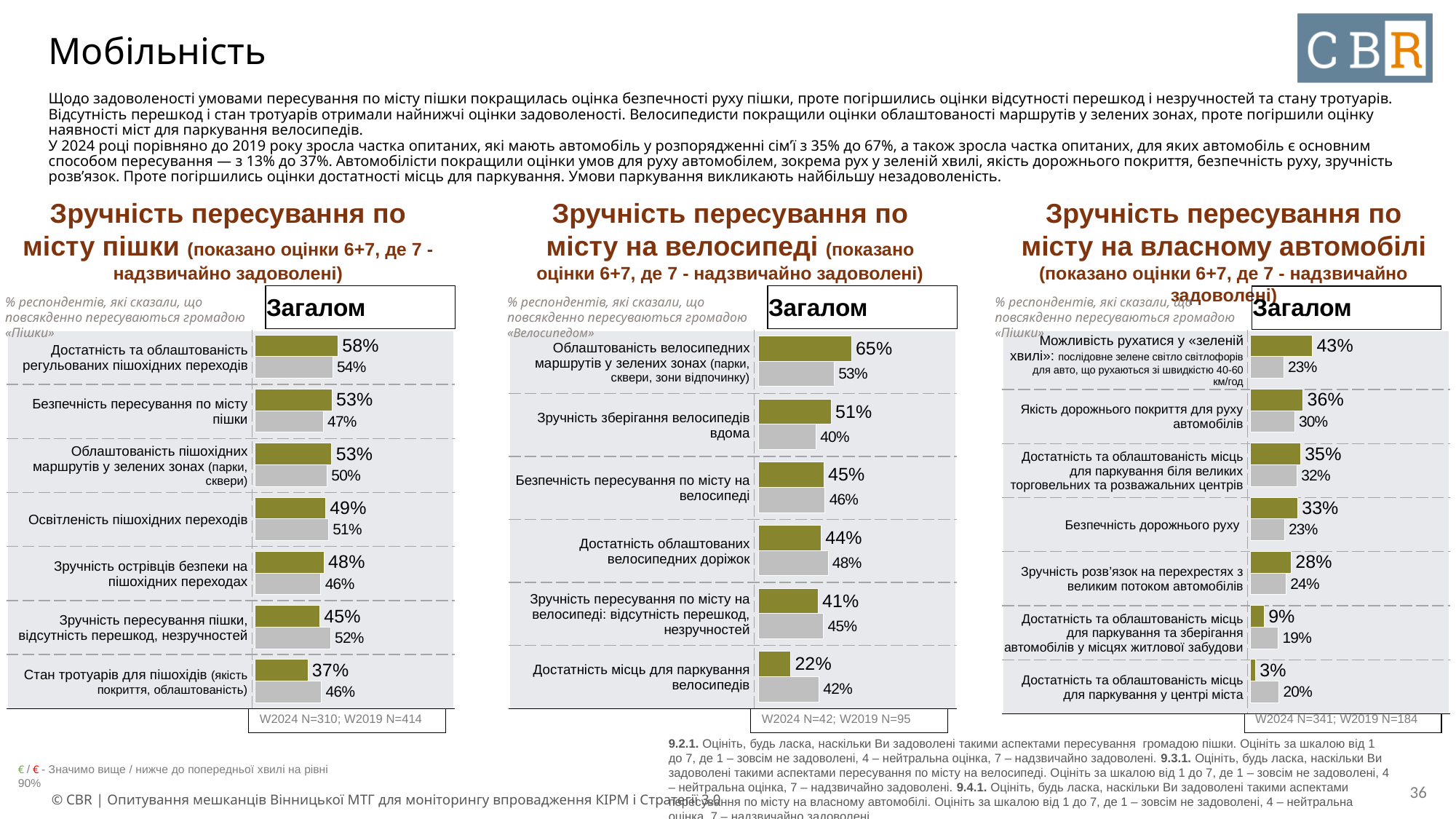
What type of chart is used for the three charts on this slide? bar chart In the right chart (Зручність пересування по місту на власному автомобілі), what is the difference between the grey and olive bars for «Достатність та облаштованість місць для паркування у центрі міста»? 17% In the left chart (Зручність пересування по місту пішки), what is the value of the grey (bottom) bar for «Освітленість пішохідних переходів»? 51% In the left chart (Зручність пересування по місту пішки), which category has the highest olive (top) bar value? Достатність та облаштованість регульованих пішохідних переходів In the right chart (Зручність пересування по місту на власному автомобілі), what is the olive (top) bar value for «Достатність та облаштованість місць для паркування у центрі міста»? 3% In the left chart (Зручність пересування по місту пішки), how many categories are shown? 7 In the middle chart (Зручність пересування по місту на велосипеді), what is the olive (top) bar value for «Достатність місць для паркування велосипедів»? 22% In the left chart (Зручність пересування по місту пішки), what is the value of the olive (top) bar for «Стан тротуарів для пішоходів»? 37% In the right chart (Зручність пересування по місту на власному автомобілі), which is larger for «Безпечність дорожнього руху»: the olive bar or the grey bar? the olive bar (33%) In the middle chart (Зручність пересування по місту на велосипеді), what is the difference between the olive and grey bars for «Облаштованість велосипедних маршрутів у зелених зонах»? 12% In the middle chart (Зручність пересування по місту на велосипеді), which category has the lowest olive (top) bar value? Достатність місць для паркування велосипедів In the middle chart (Зручність пересування по місту на велосипеді), how many categories are shown? 6